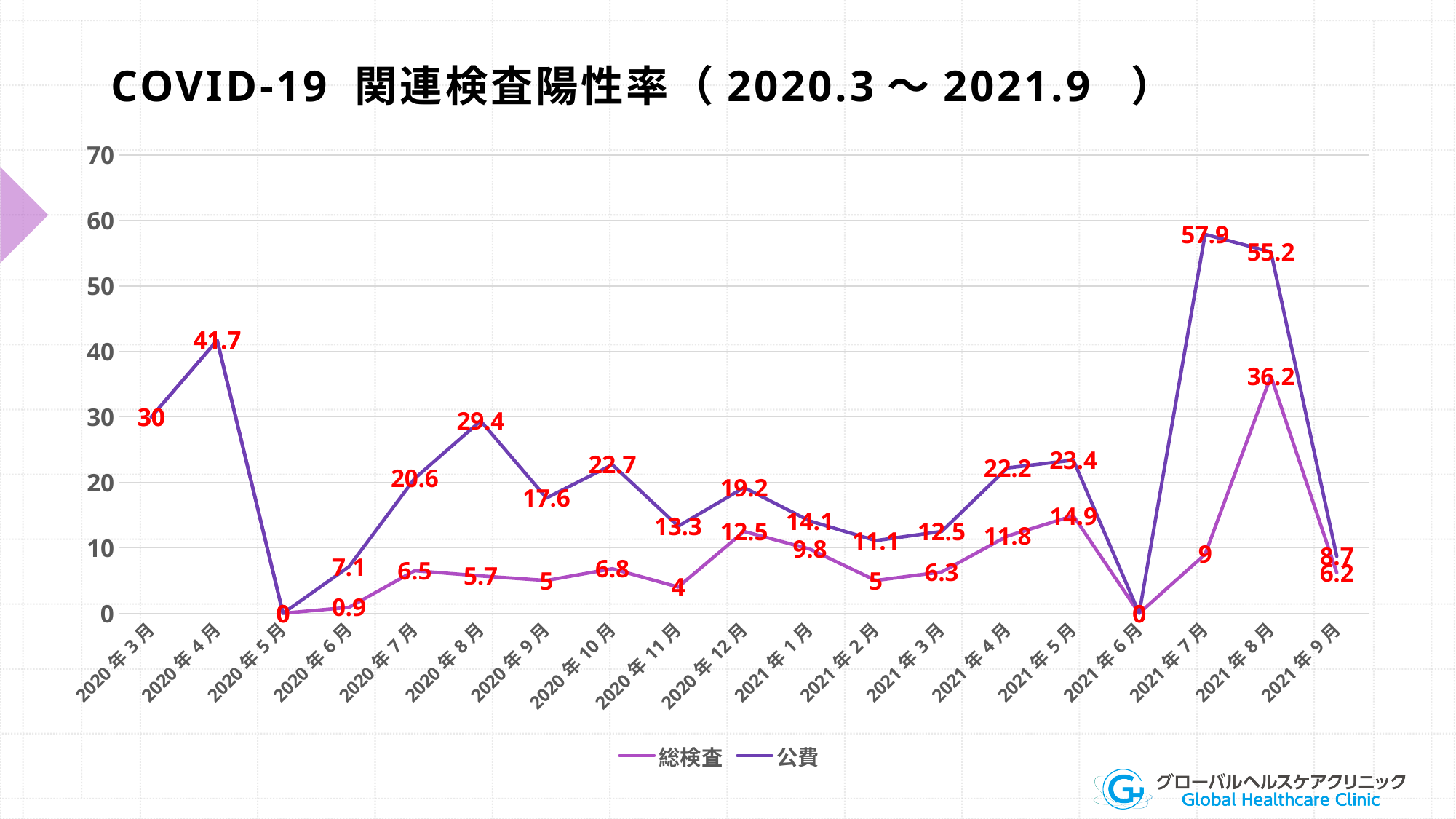
What is the 総検査 value for 2021年8月? 36.2 What is the difference between the 公費 and 総検査 values for 2021年8月? 19 What is the 公費 value for 2021年7月? 57.9 How many months are plotted along the x axis? 19 What is the 公費 value for 2020年8月? 29.4 In which month is the 総検査 value highest? 2020年4月 For 2020年12月, which series has the larger value, 公費 or 総検査? 公費 In which month is the 公費 value highest? 2021年7月 What are the two entries in the legend? 総検査 and 公費 What kind of chart is shown on the slide? line chart What is the 総検査 value for 2020年6月? 0.9 How many series does the legend list? 2